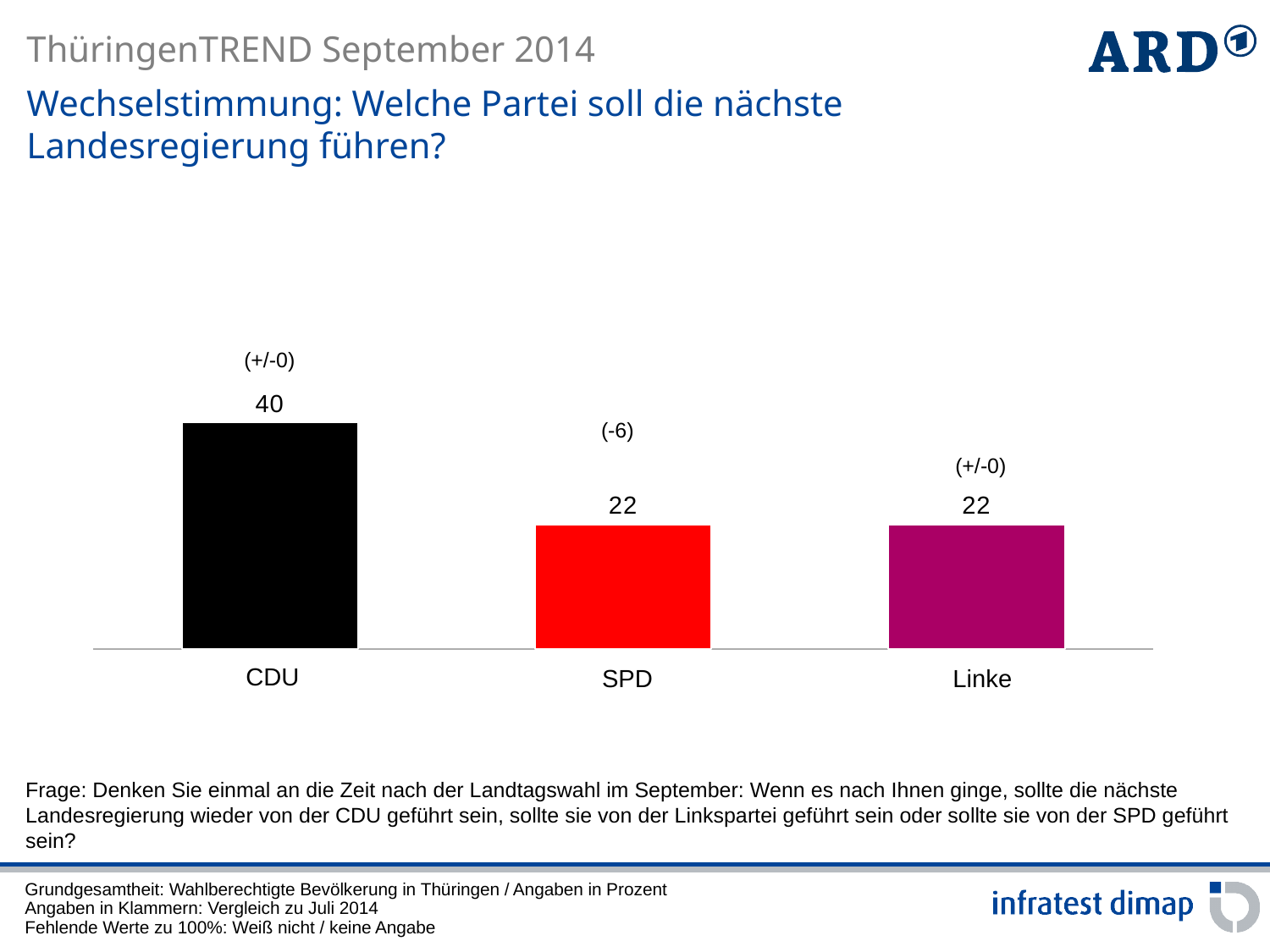
Which is larger, the value for CDU or the value for Linke? CDU What kind of chart is shown on the slide? bar chart What is the value for CDU? 40 What is the value for Linke? 22 What is the value for SPD? 22 What is the change compared to July 2014 shown in brackets for CDU? (+/-0) What is the change compared to July 2014 shown in brackets for SPD? (-6) What colour is the bar for SPD? red How many parties are shown in the chart? 3 What is the difference between the values for CDU and SPD? 18 What colour is the bar for CDU? black Which party has the highest value? CDU